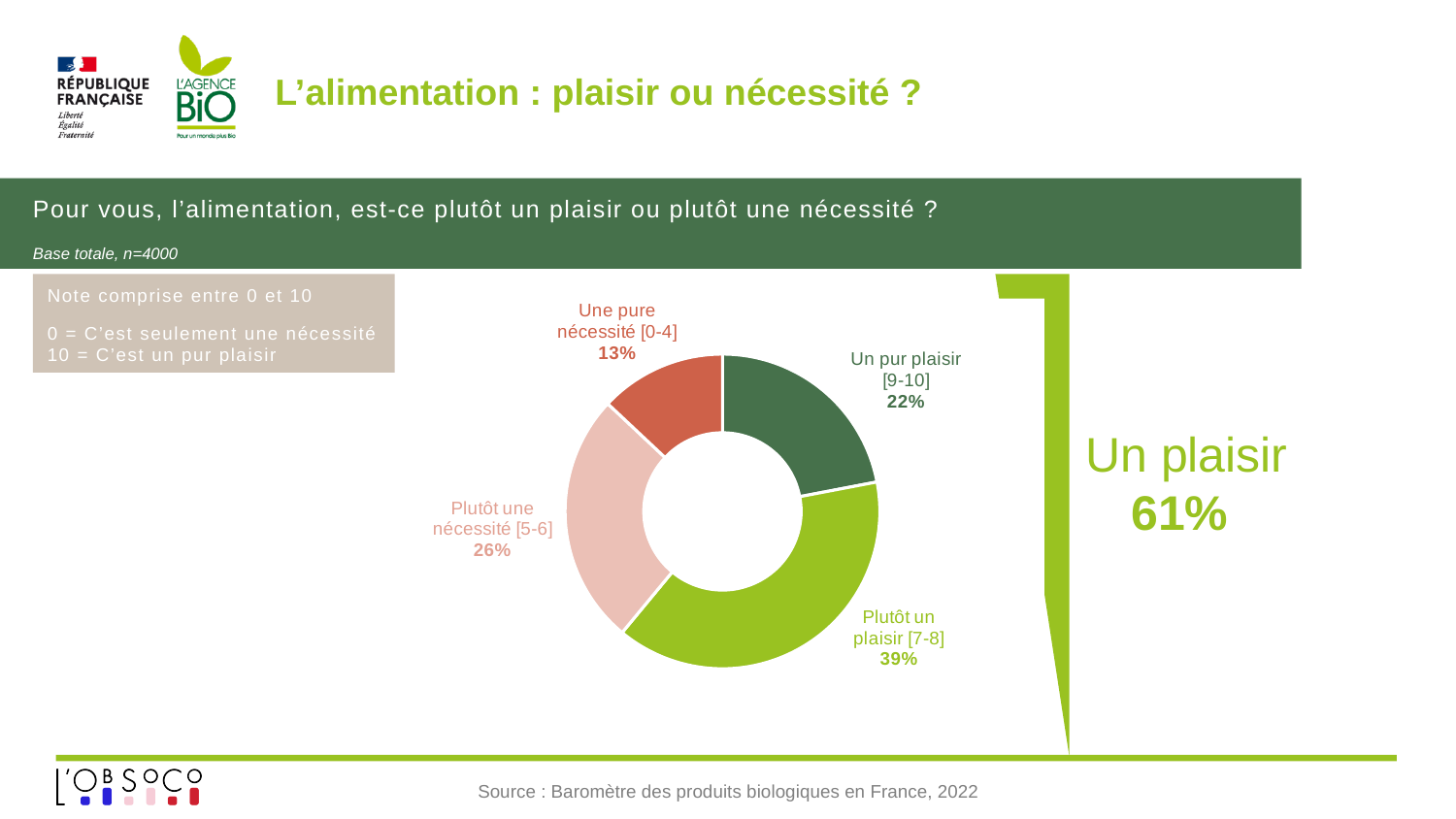
What percentage of respondents answered "Plutôt une nécessité [5-6]"? 26% Which category has the largest share of the chart? Plutôt un plaisir [7-8] What percentage of respondents answered "Une pure nécessité [0-4]"? 13% What percentage of respondents answered "Plutôt un plaisir [7-8]"? 39% What percentage of respondents answered "Un pur plaisir [9-10]"? 22% What is the difference in percentage points between "Plutôt un plaisir [7-8]" and "Un pur plaisir [9-10]"? 17 Which is larger: the share for "Plutôt une nécessité [5-6]" or the share for "Un pur plaisir [9-10]"? Plutôt une nécessité [5-6] What kind of chart is shown on the slide? Doughnut chart What is the sample size (base) stated for the chart? n=4000 What combined percentage is highlighted to the right of the chart for "Un plaisir"? 61% How many categories are shown in the chart? 4 Which category has the smallest share of the chart? Une pure nécessité [0-4]